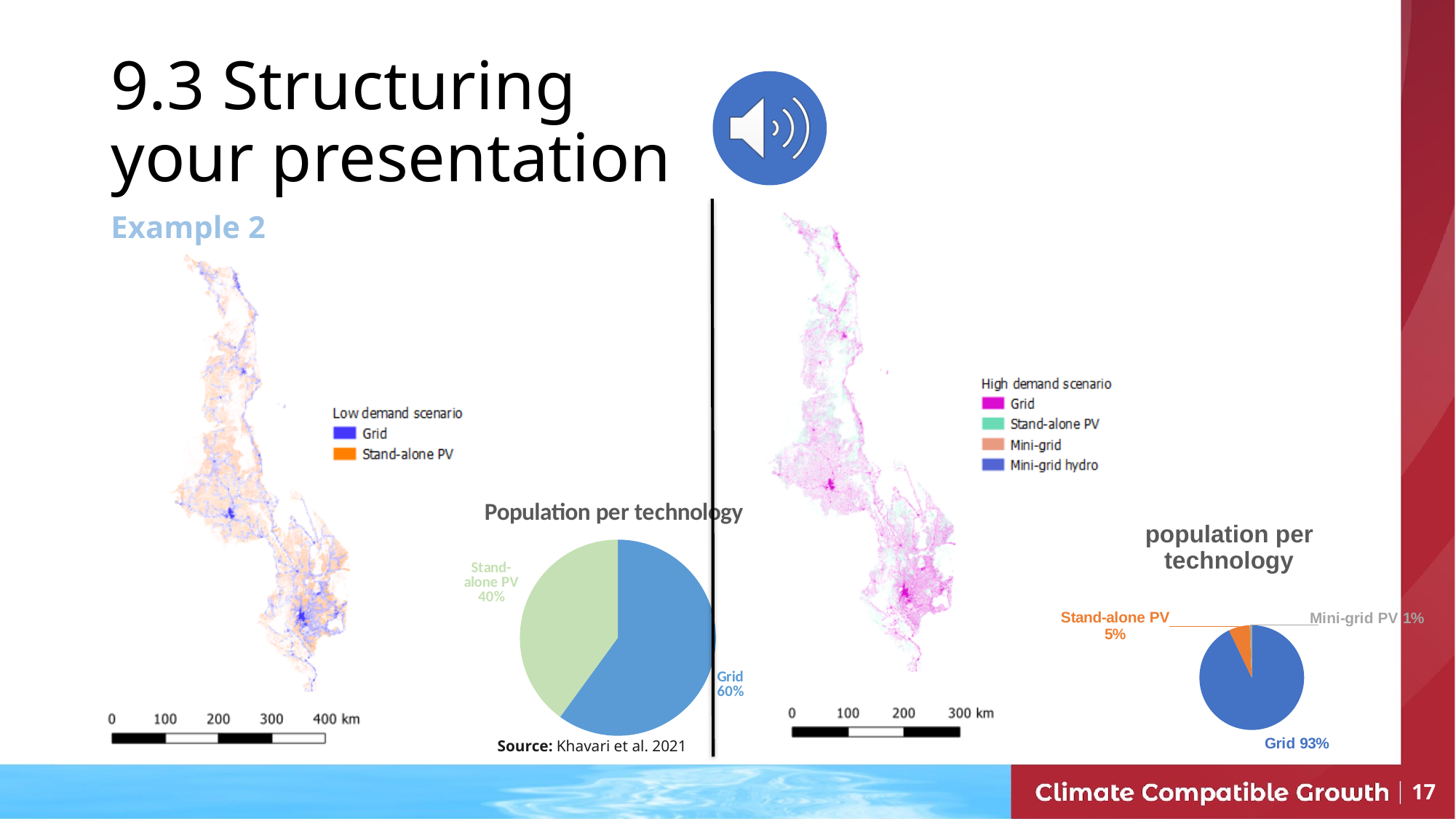
What source is cited below the left pie chart? Khavari et al. 2021 What kind of chart is the left chart titled 'Population per technology'? Pie chart In the right pie chart titled 'population per technology', which is larger, Stand-alone PV or Mini-grid PV? Stand-alone PV In the right pie chart titled 'population per technology', what share does Grid have? 93% In the left pie chart titled 'Population per technology', what is the difference between the Grid share and the Stand-alone PV share? 20% In the left pie chart titled 'Population per technology', which category has the largest share? Grid In the right pie chart titled 'population per technology', what share does Stand-alone PV have? 5% In the left pie chart titled 'Population per technology', what share does Stand-alone PV have? 40% In the left pie chart titled 'Population per technology', what share does Grid have? 60% In the right pie chart titled 'population per technology', what share does Mini-grid PV have? 1%